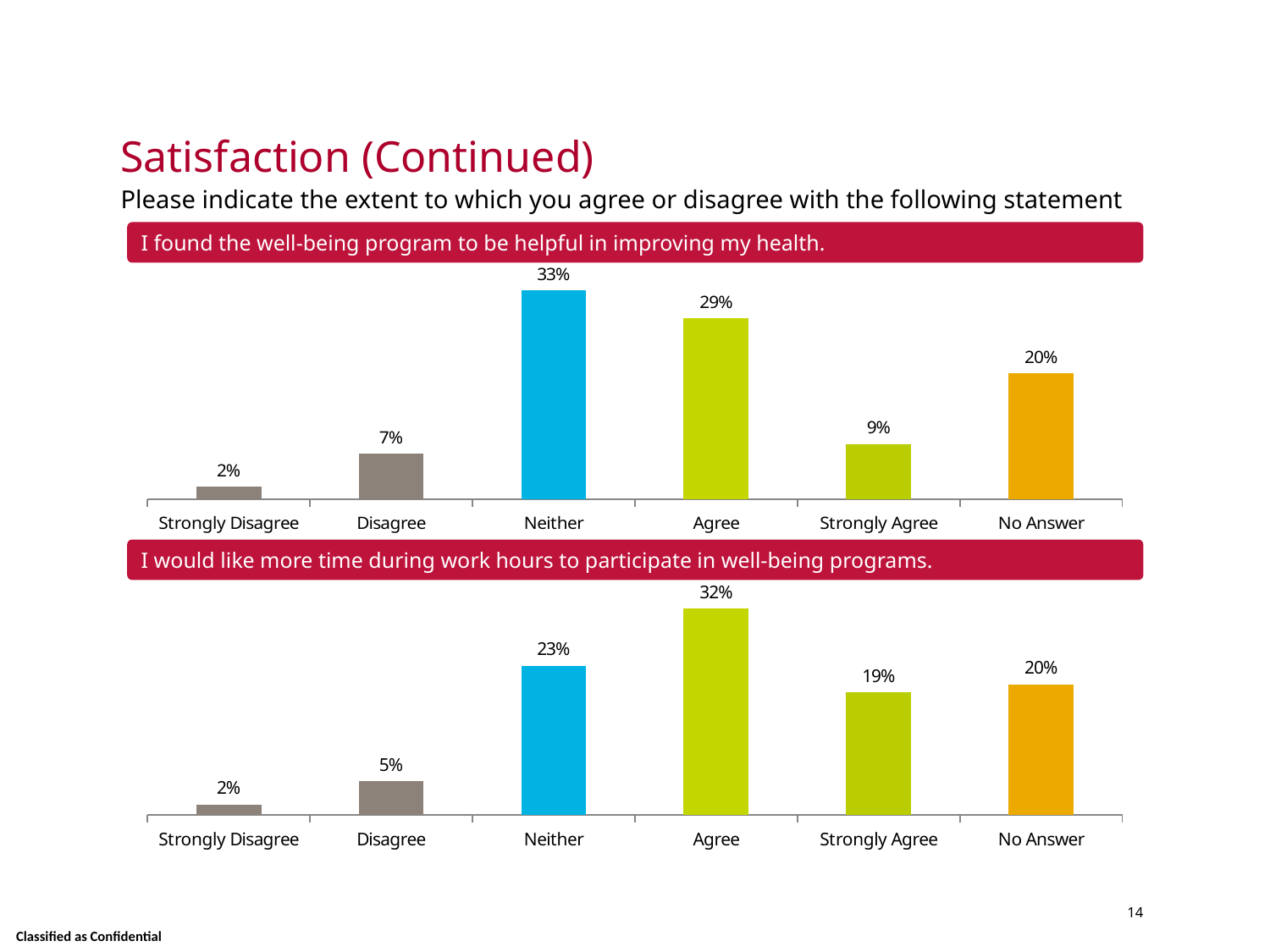
How many categories are shown in the chart for 'I found the well-being program to be helpful in improving my health.'? 6 In the chart for 'I found the well-being program to be helpful in improving my health.', what is the value for Neither? 33% In the chart for 'I would like more time during work hours to participate in well-being programs.', what is the value for Disagree? 5% In the chart for 'I would like more time during work hours to participate in well-being programs.', which category has the lowest value? Strongly Disagree In the chart for 'I found the well-being program to be helpful in improving my health.', which category has the highest value? Neither In the chart for 'I would like more time during work hours to participate in well-being programs.', what is the difference between the values for Agree and Neither? 9% In the chart for 'I would like more time during work hours to participate in well-being programs.', which is larger, Strongly Agree or No Answer? No Answer In the chart for 'I found the well-being program to be helpful in improving my health.', what is the difference between the values for Agree and Strongly Agree? 20% In the chart for 'I found the well-being program to be helpful in improving my health.', what colour is the Neither bar? Blue In the chart for 'I found the well-being program to be helpful in improving my health.', what is the value for Strongly Agree? 9% What kind of chart is used for 'I would like more time during work hours to participate in well-being programs.'? Bar chart In the chart for 'I would like more time during work hours to participate in well-being programs.', what is the value for Agree? 32%